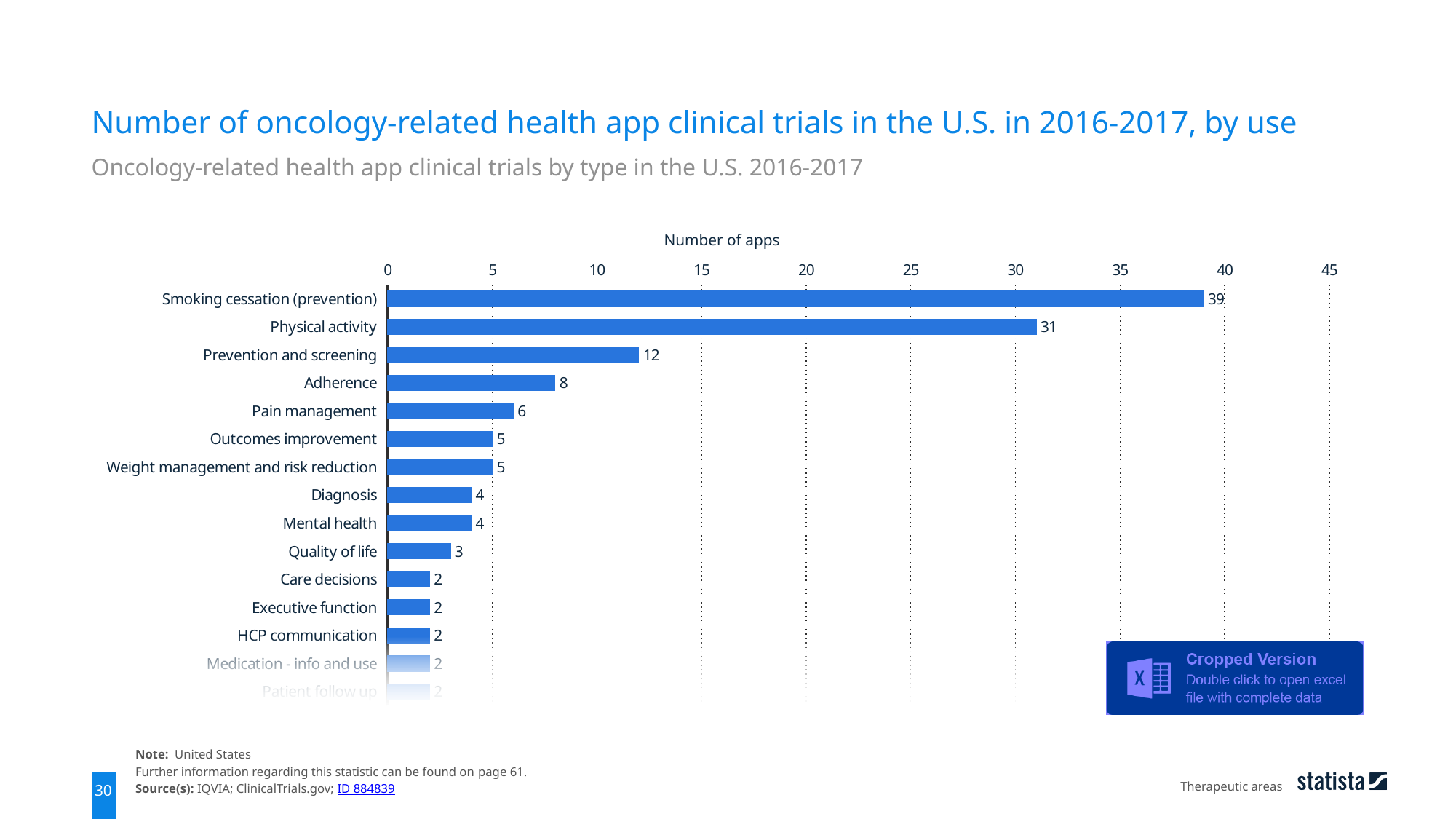
What is the number of apps for Adherence? 8 What is the number of apps for Quality of life? 3 Is the value for Physical activity greater or less than 30? greater What kind of chart is shown on the slide? Bar chart What is the difference in number of apps between Smoking cessation (prevention) and Physical activity? 8 What is the number of apps for Prevention and screening? 12 What is the number of apps for Pain management? 6 What is the label of the horizontal axis? Number of apps Which use category has the highest number of apps? Smoking cessation (prevention) What is the number of apps for Smoking cessation (prevention)? 39 What is the number of apps for Physical activity? 31 Which has more apps, Prevention and screening or Adherence? Prevention and screening